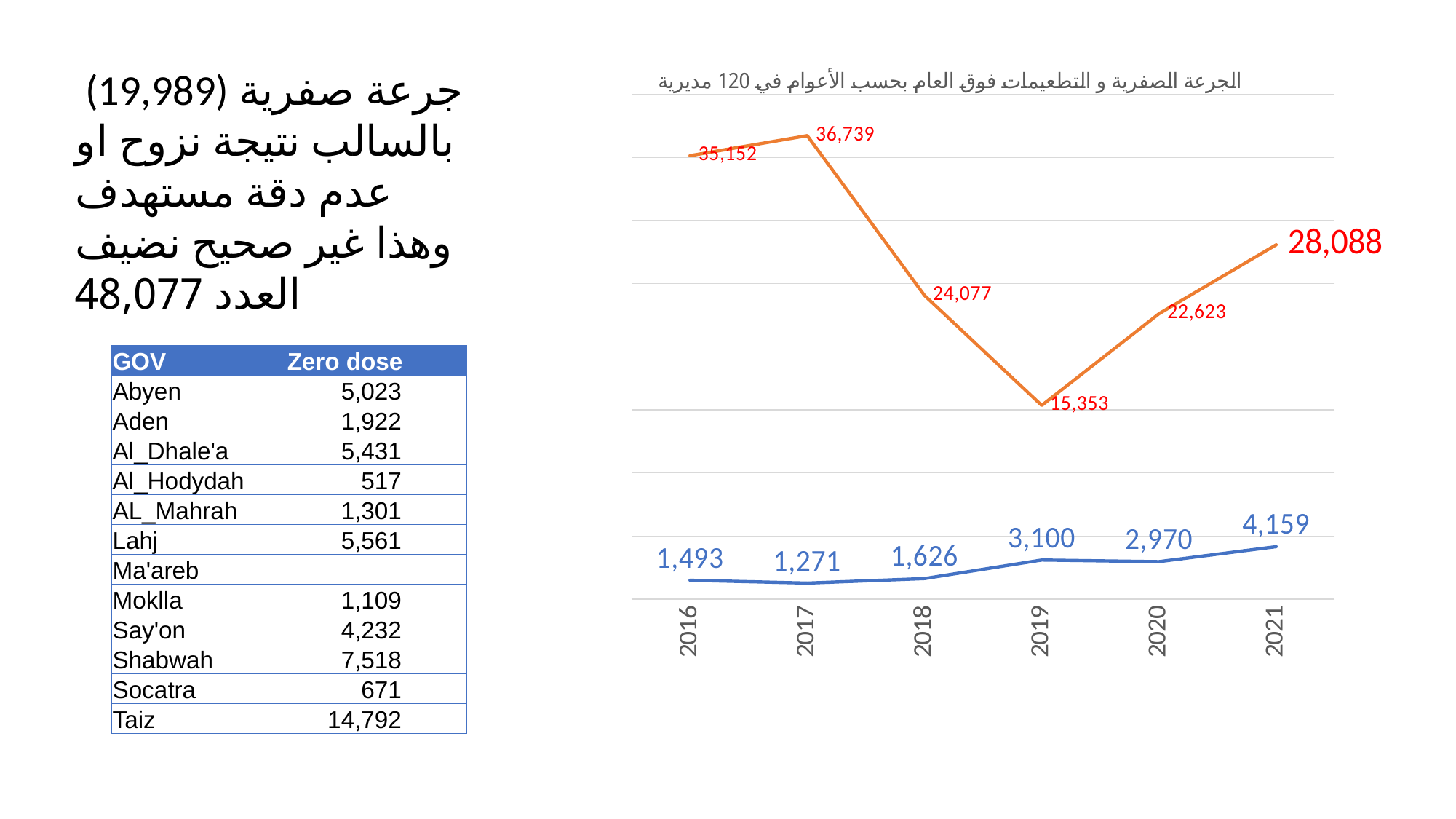
How many lines (data series) are plotted on the chart? 2 What type of chart is shown on the slide? Line chart Does the orange line rise or fall from 2019 to 2021? Rise What is the value of the orange line in 2017? 36,739 How many years are shown on the x axis? 6 What is the value of the orange line in 2019? 15,353 In which year does the orange line reach its lowest value? 2019 In which year does the orange line reach its highest value? 2017 What is the difference between the orange line's values in 2017 and 2019? 21,386 What is the value of the blue line in 2021? 4,159 In which year does the blue line reach its lowest value? 2017 Which is larger for the blue line: the value in 2019 or the value in 2020? 2019